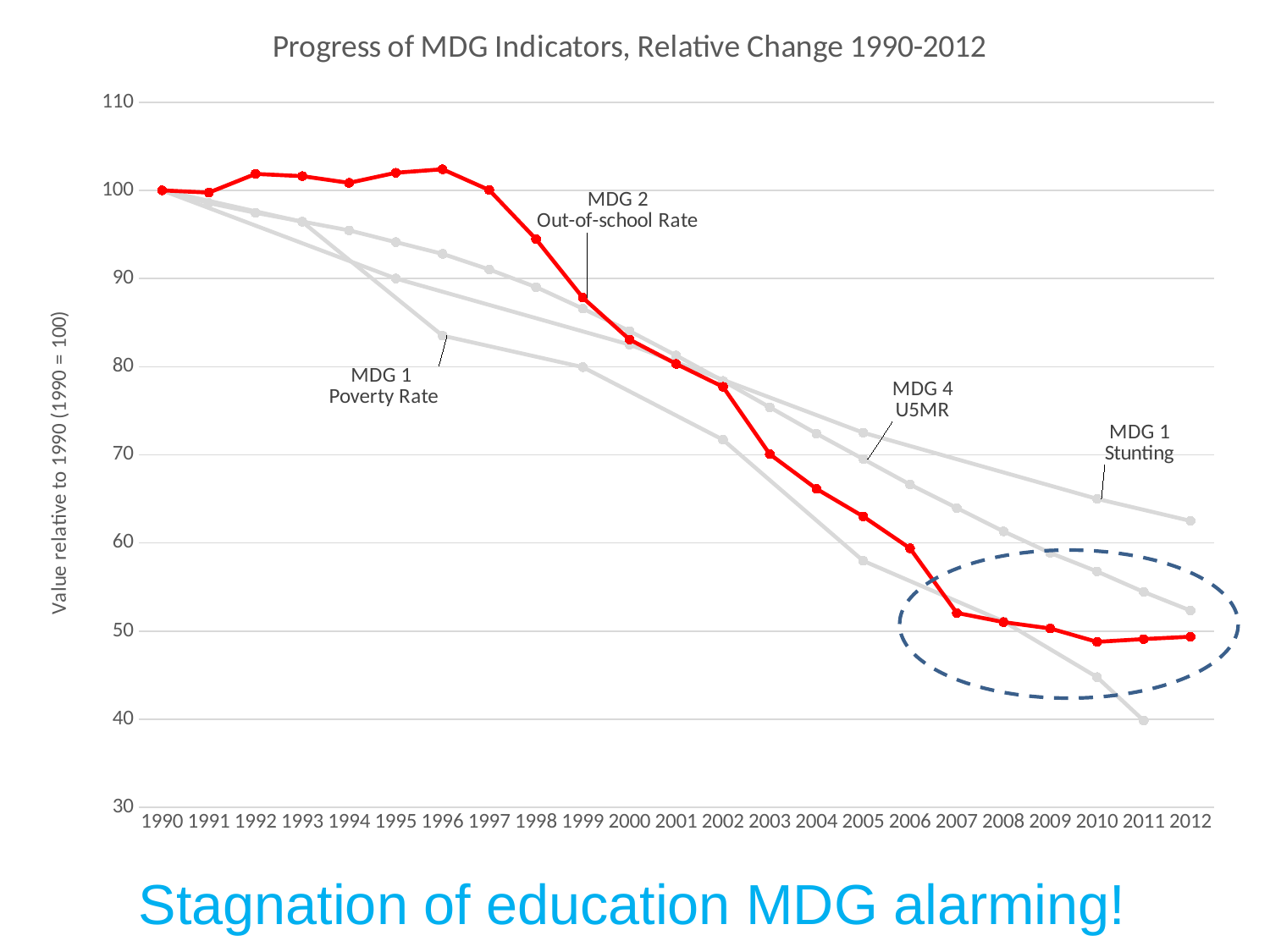
What is the label on the vertical axis of the chart? Value relative to 1990 (1990 = 100) Is the value of the MDG 1 Stunting line in 2012 greater or less than 60? greater What is the title of the chart? Progress of MDG Indicators, Relative Change 1990-2012 What type of chart is shown on the slide? line chart Which indicator line has the lowest value in 2011? MDG 1 Poverty Rate Is the value of the MDG 2 Out-of-school Rate line in 2012 greater or less than 60? less How many MDG indicator lines are plotted on the chart? 4 How many years are shown along the x axis of the chart? 23 Is the value of the MDG 1 Poverty Rate line in 2011 greater or less than 50? less In 2005, which is larger: the MDG 4 U5MR line or the MDG 1 Poverty Rate line? MDG 4 U5MR Which indicator line has the highest value in 2012? MDG 1 Stunting What is the value of the MDG 2 Out-of-school Rate line in 1990? 100